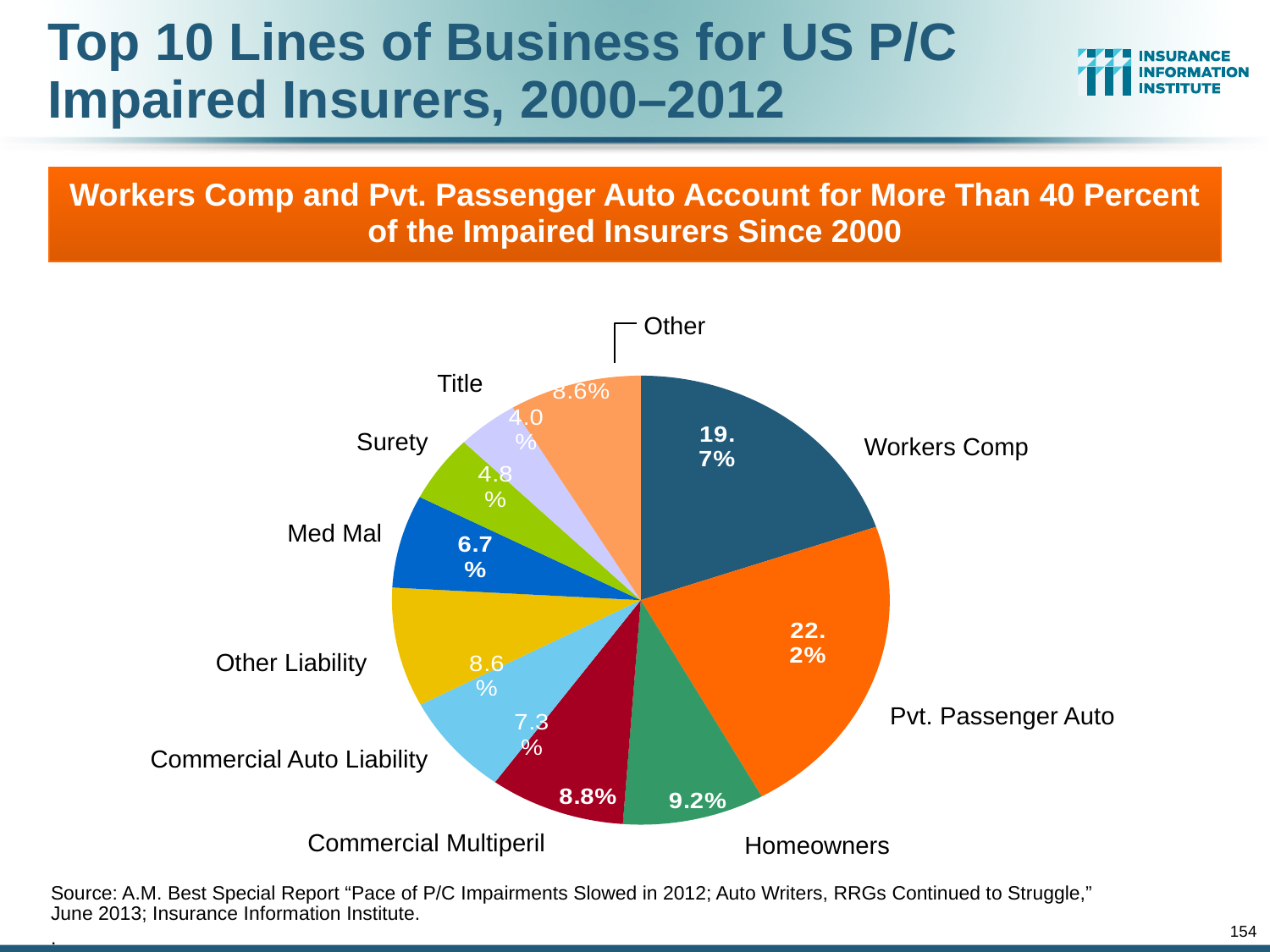
Which is larger, the share for Surety or the share for Med Mal? Med Mal What is the value shown for Homeowners? 9.2% What share of impaired insurers is attributed to Workers Comp? 19.7% What is the difference between the Pvt. Passenger Auto share and the Workers Comp share? 2.5% What is the value shown for Med Mal? 6.7% Which line of business has the largest slice of the pie? Pvt. Passenger Auto What is the value shown for Title? 4.0% What is the value shown for Commercial Multiperil? 8.8% What share of impaired insurers is attributed to Pvt. Passenger Auto? 22.2% What kind of chart is shown on the slide? pie chart How many slices does the pie chart have? 10 Which line of business has the smallest slice of the pie? Title